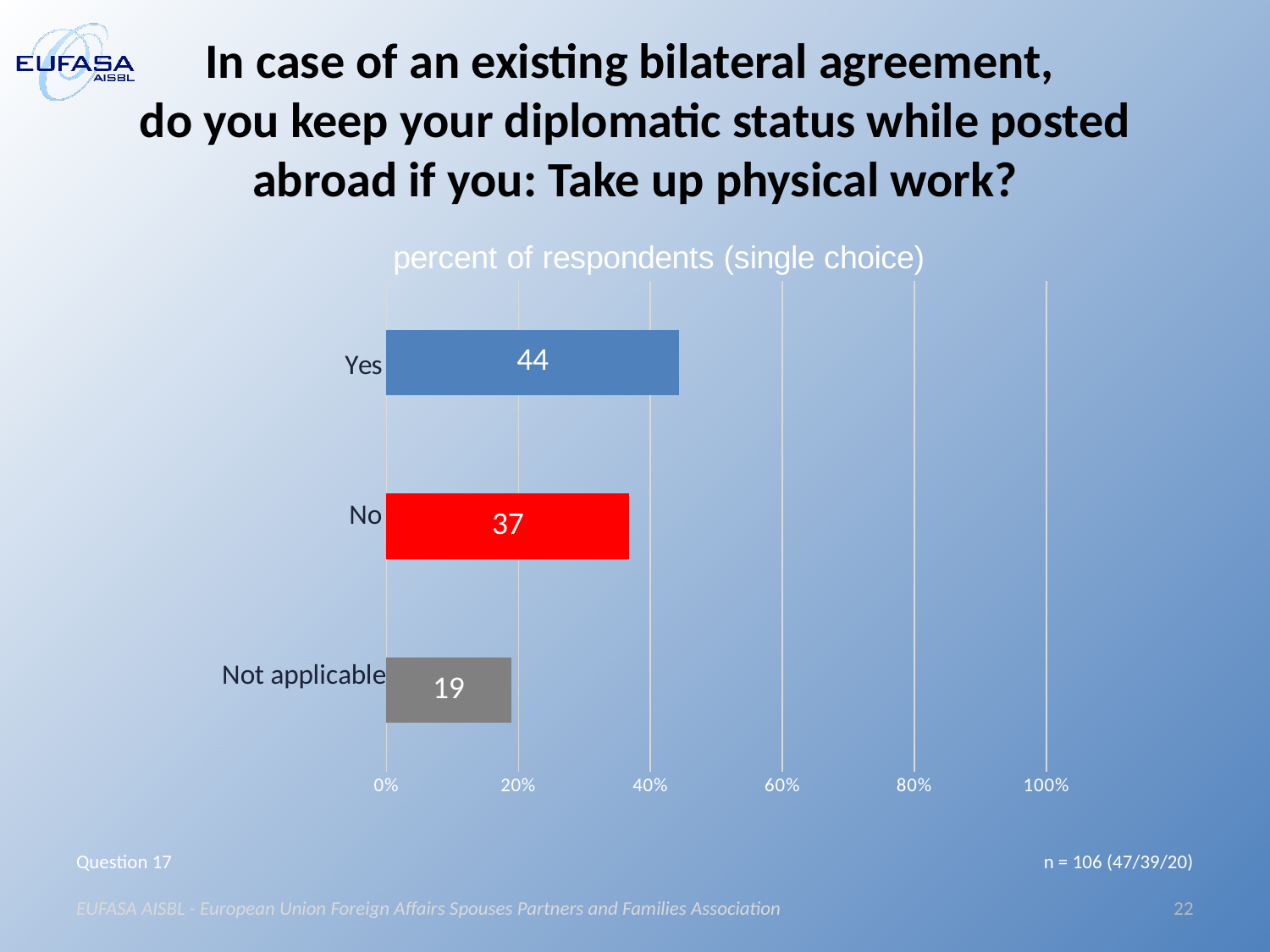
What is the value for Not applicable? 19 What is the difference between the values for Yes and No? 7 What is the value for No? 37 Which category has the highest value? Yes Which is larger, the value for Yes or the value for Not applicable? Yes How many categories are shown in the chart? 3 What is the value for Yes? 44 Is the value for Yes greater or less than 40%? greater Which category has the lowest value? Not applicable What is the title of the chart? percent of respondents (single choice) What is the difference between the values for No and Not applicable? 18 What kind of chart is shown on the slide? bar chart